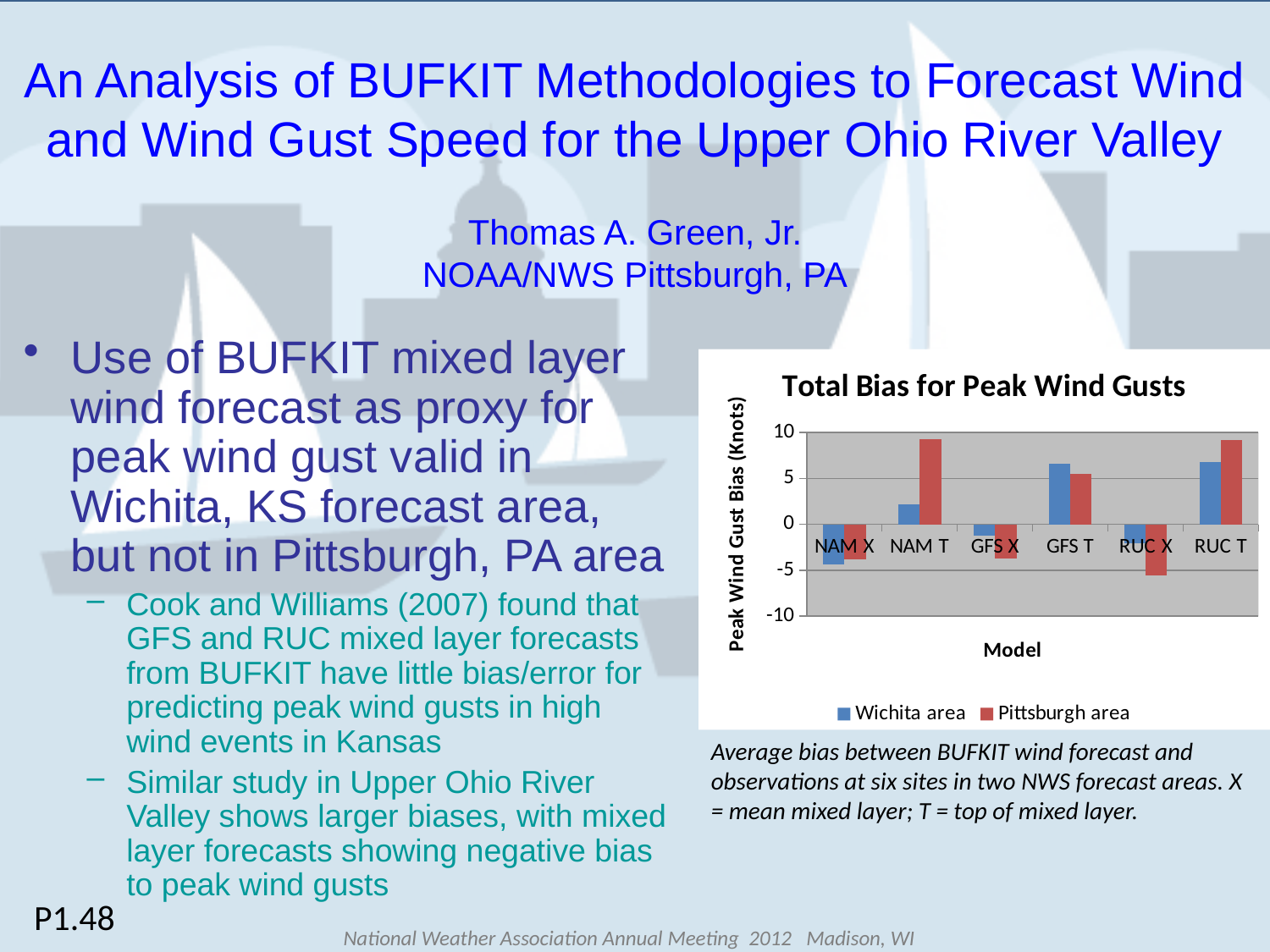
Is the Pittsburgh area value for RUC X greater or less than 0? less For NAM T, which series has the larger value, Wichita area or Pittsburgh area? Pittsburgh area Is the Pittsburgh area value for NAM T greater or less than 5? greater Which model has the lowest Pittsburgh area bias? RUC X How many model categories are shown on the x axis of the chart? 6 Is the Wichita area value for GFS T greater or less than 5? greater Which model has the lowest Wichita area bias? NAM X What is the label of the vertical axis of the chart? Peak Wind Gust Bias (Knots) What is the title of the chart? Total Bias for Peak Wind Gusts What kind of chart is shown on the slide? bar chart How many series does the chart legend list? 2